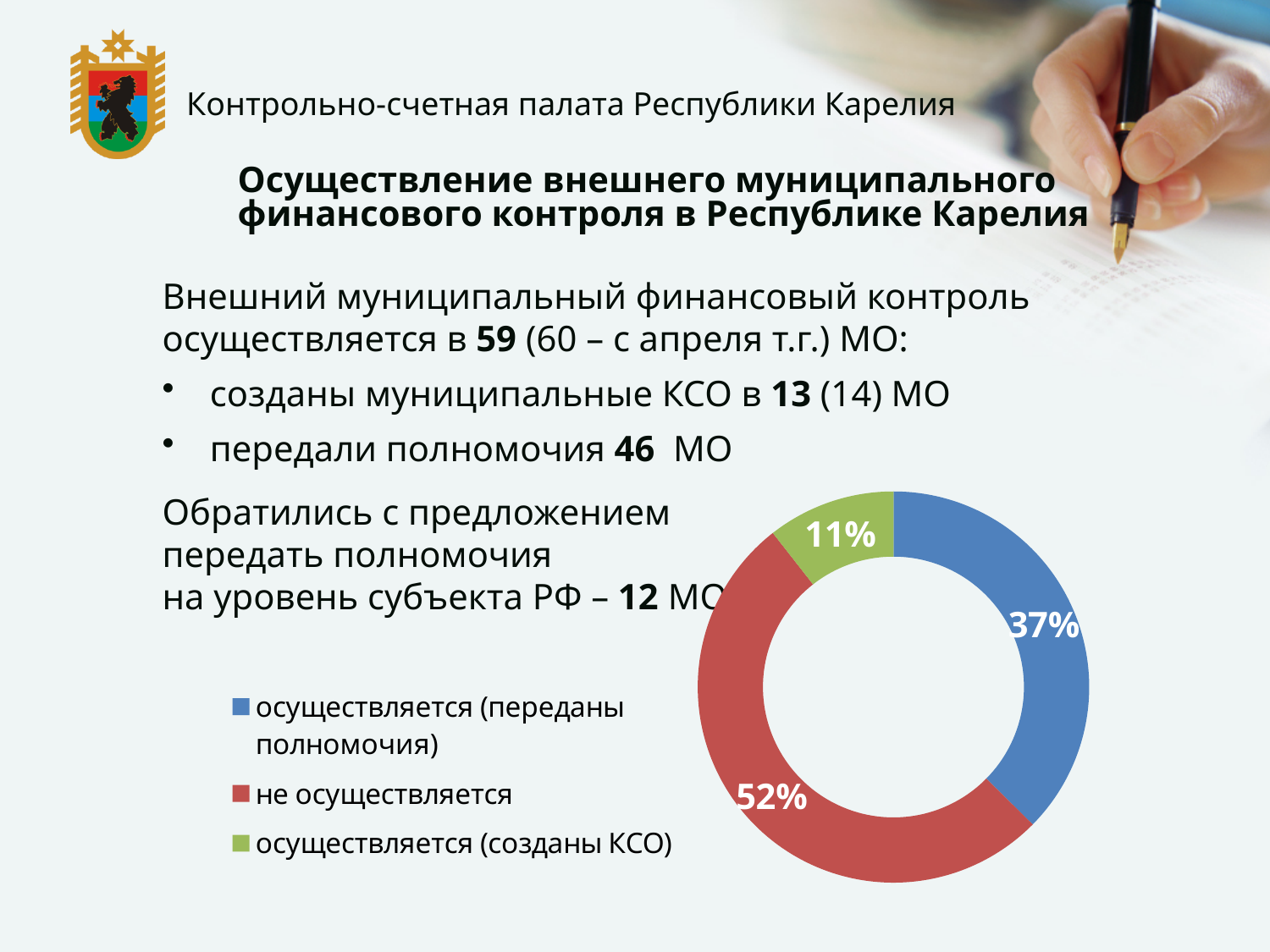
Which category has the largest share of the doughnut chart? не осуществляется Which category has the smallest share of the doughnut chart? осуществляется (созданы КСО) What kind of chart is shown on the slide? doughnut chart How many entries does the chart legend list? 3 What is the combined share of the two "осуществляется" slices (переданы полномочия and созданы КСО)? 48% What percentage is shown for the slice "осуществляется (созданы КСО)"? 11% What percentage is shown for the slice "осуществляется (переданы полномочия)"? 37% What colour is the slice labelled "не осуществляется"? red What is the difference in percentage points between "не осуществляется" and "осуществляется (переданы полномочия)"? 15 How many slices does the doughnut chart have? 3 Which is larger: the share for "осуществляется (переданы полномочия)" or the share for "осуществляется (созданы КСО)"? осуществляется (переданы полномочия) What percentage is shown for the slice "не осуществляется"? 52%